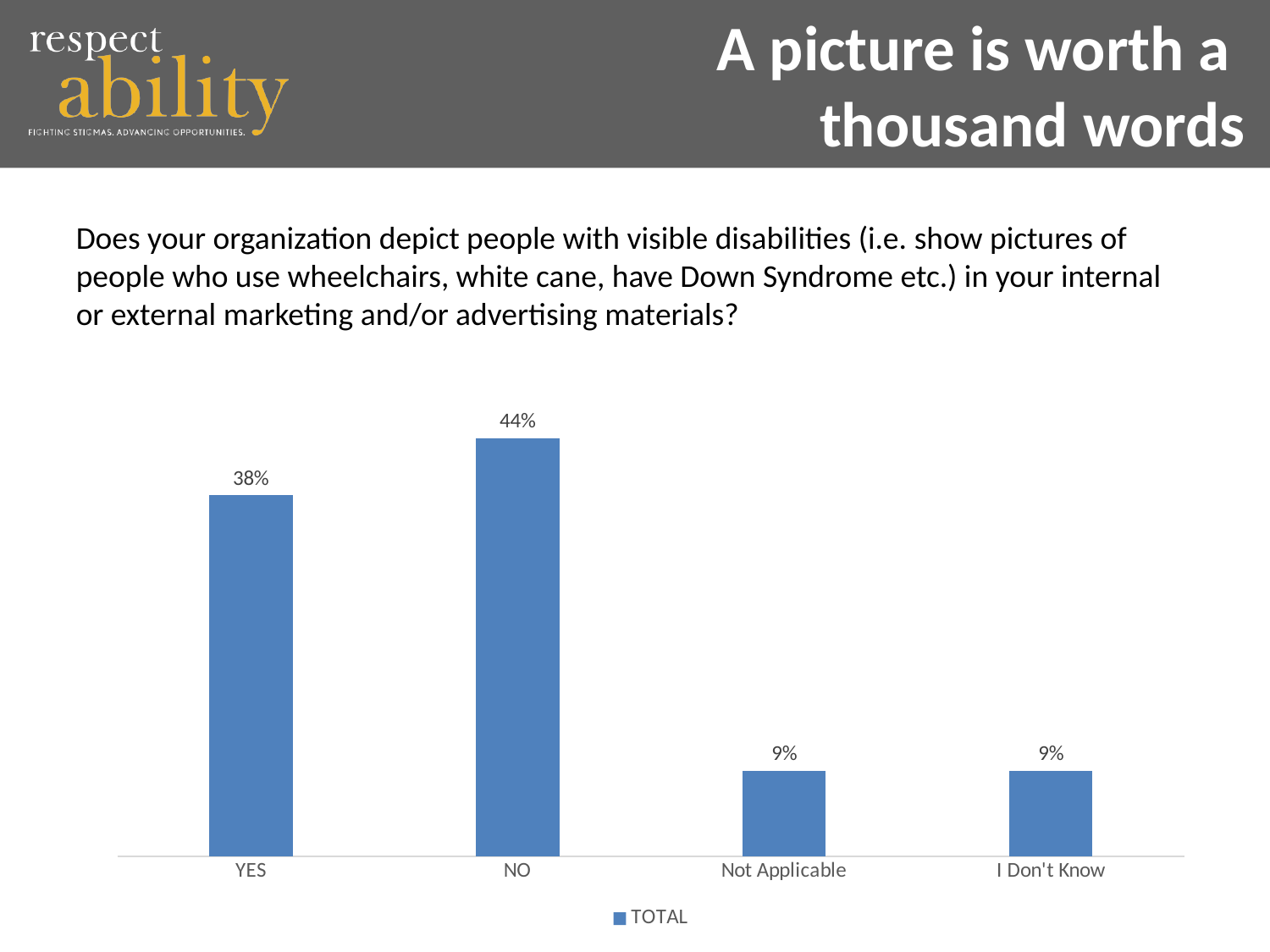
How many series does the legend list? 1 What is the value for NO? 44% What is the name of the series shown in the legend? TOTAL What is the difference between the values for NO and YES? 6% What is the value for I Don't Know? 9% What is the value for Not Applicable? 9% Which category has the highest value? NO Which is larger, the value for YES or the value for NO? NO What kind of chart is shown on the slide? Bar chart What is the difference between the values for YES and Not Applicable? 29% How many categories are shown on the x axis? 4 What is the value for YES? 38%